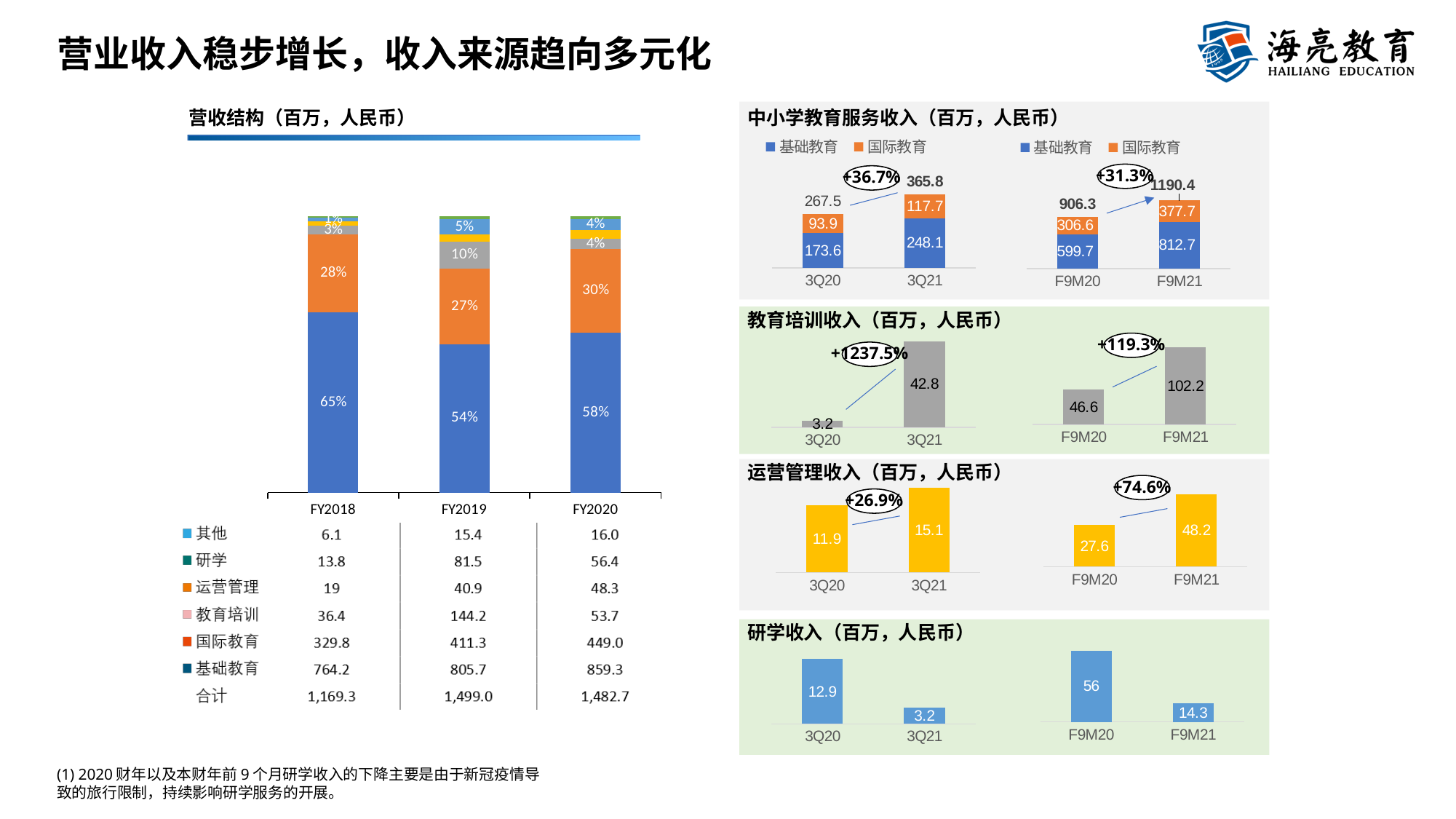
In the 中小学教育服务收入 chart, what is the 基础教育 value for 3Q21? 248.1 In the 营收结构 chart, what percentage share does 基础教育 have in FY2018? 65% In the 教育培训收入 chart, which period has the highest value? F9M21 In the 运营管理收入 chart, what is the difference between F9M21 and F9M20? 20.6 In the 营收结构 chart, what kind of chart is it? Stacked bar chart In the 中小学教育服务收入 chart, what is the difference between the 国际教育 values for F9M21 and F9M20? 71.1 In the 营收结构 chart, how many fiscal years are shown on the x axis? 3 In the 研学收入 chart, which is larger, the value for 3Q20 or 3Q21? 3Q20 In the 营收结构 chart, what percentage share does 国际教育 have in FY2020? 30% In the 中小学教育服务收入 chart, how many series does the legend list? 2 In the 中小学教育服务收入 chart, what is the total for F9M21? 1190.4 In the 教育培训收入 chart, what is the value for 3Q21? 42.8